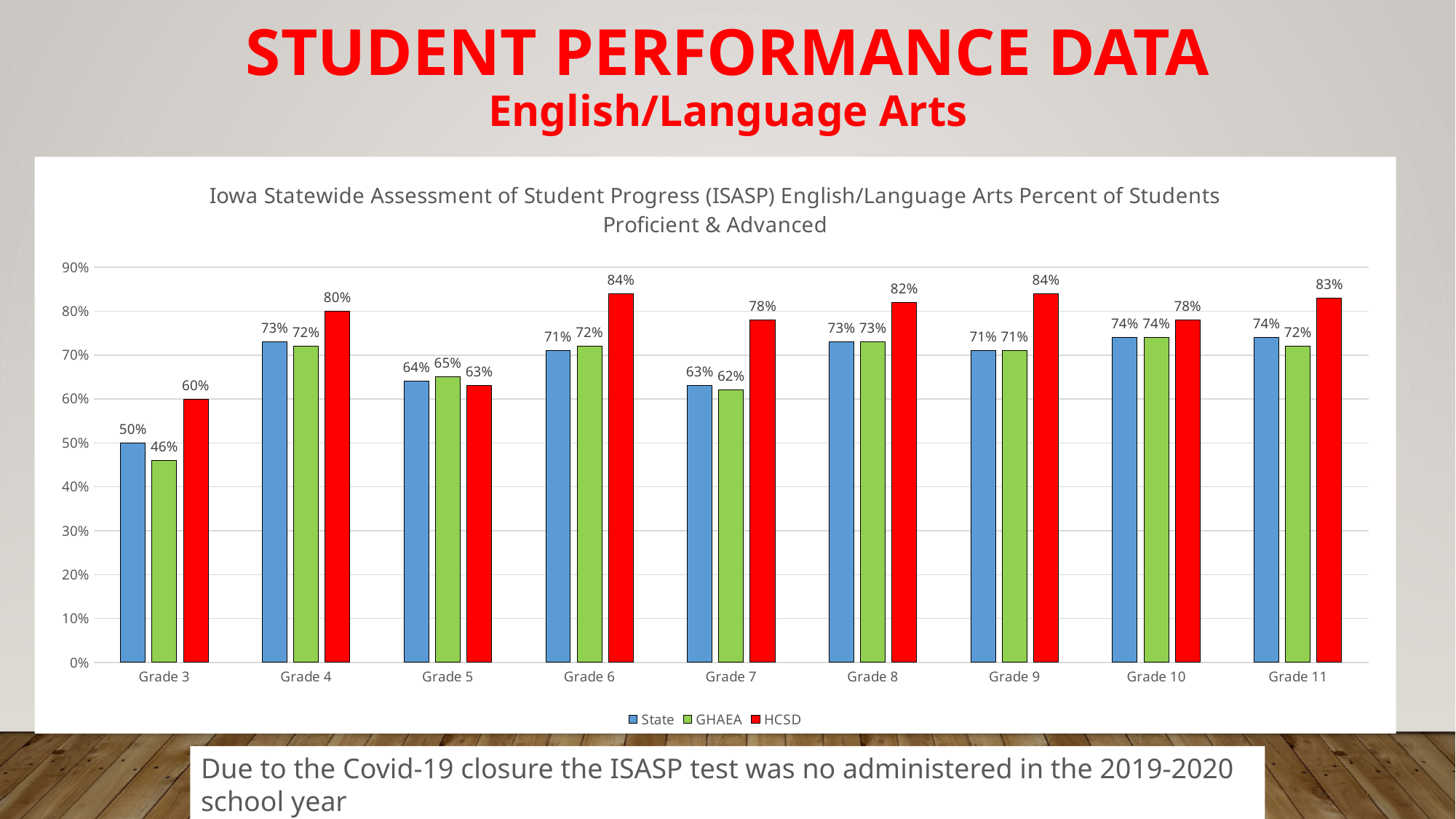
What is the State value for Grade 3? 50% What is the HCSD value for Grade 6? 84% What kind of chart is shown on the slide? Bar chart Is the HCSD value for Grade 9 greater or less than 80%? greater Which is larger for Grade 5, the State value or the HCSD value? State Which grade has the lowest GHAEA value? Grade 3 What is the GHAEA value for Grade 5? 65% How many series does the legend list? 3 What is the difference between the HCSD and State values for Grade 3? 10% Which grade has the highest State value? Grade 10 and Grade 11 Which colour represents HCSD in the chart? Red How many grades are shown on the x axis? 9